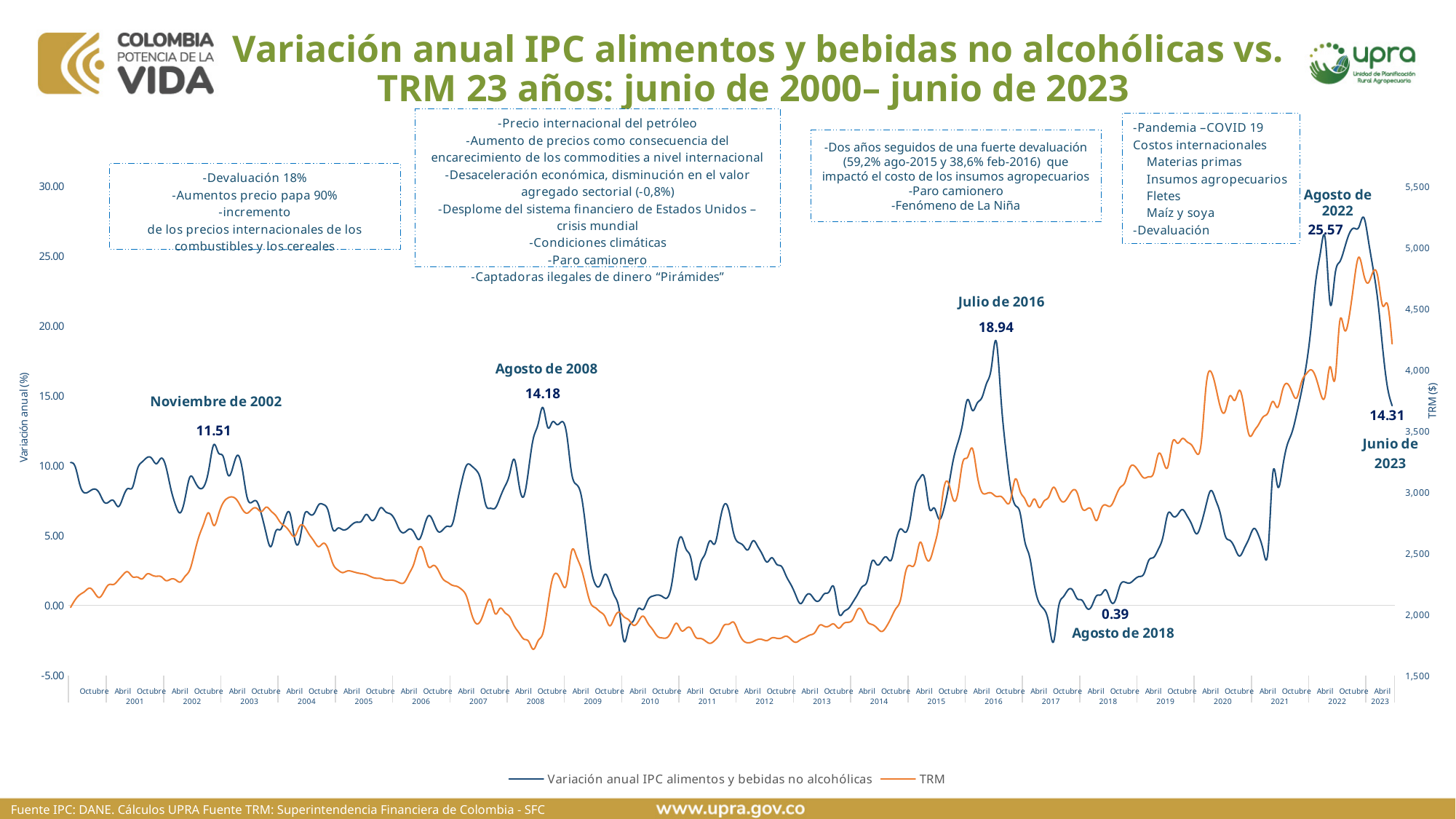
What value is labelled for the IPC series at Junio de 2023? 14.31 What value is labelled for the IPC series at Agosto de 2022? 25.57 Is the TRM value at its 2022 peak greater or less than 4,500? greater What value is labelled for the IPC series at Agosto de 2018? 0.39 What is the difference between the labelled IPC values for Agosto de 2022 and Junio de 2023? 11.26 What value is labelled for the IPC series at Julio de 2016? 18.94 Among the labelled points on the IPC line, which date has the highest value? Agosto de 2022 How many series does the legend list? 2 Among the labelled points on the IPC line, which date has the lowest value? Agosto de 2018 What is the label of the right-hand vertical axis? TRM ($) Which labelled IPC value is larger: Agosto de 2008 or Noviembre de 2002? Agosto de 2008 What kind of chart is shown on the slide? Line chart